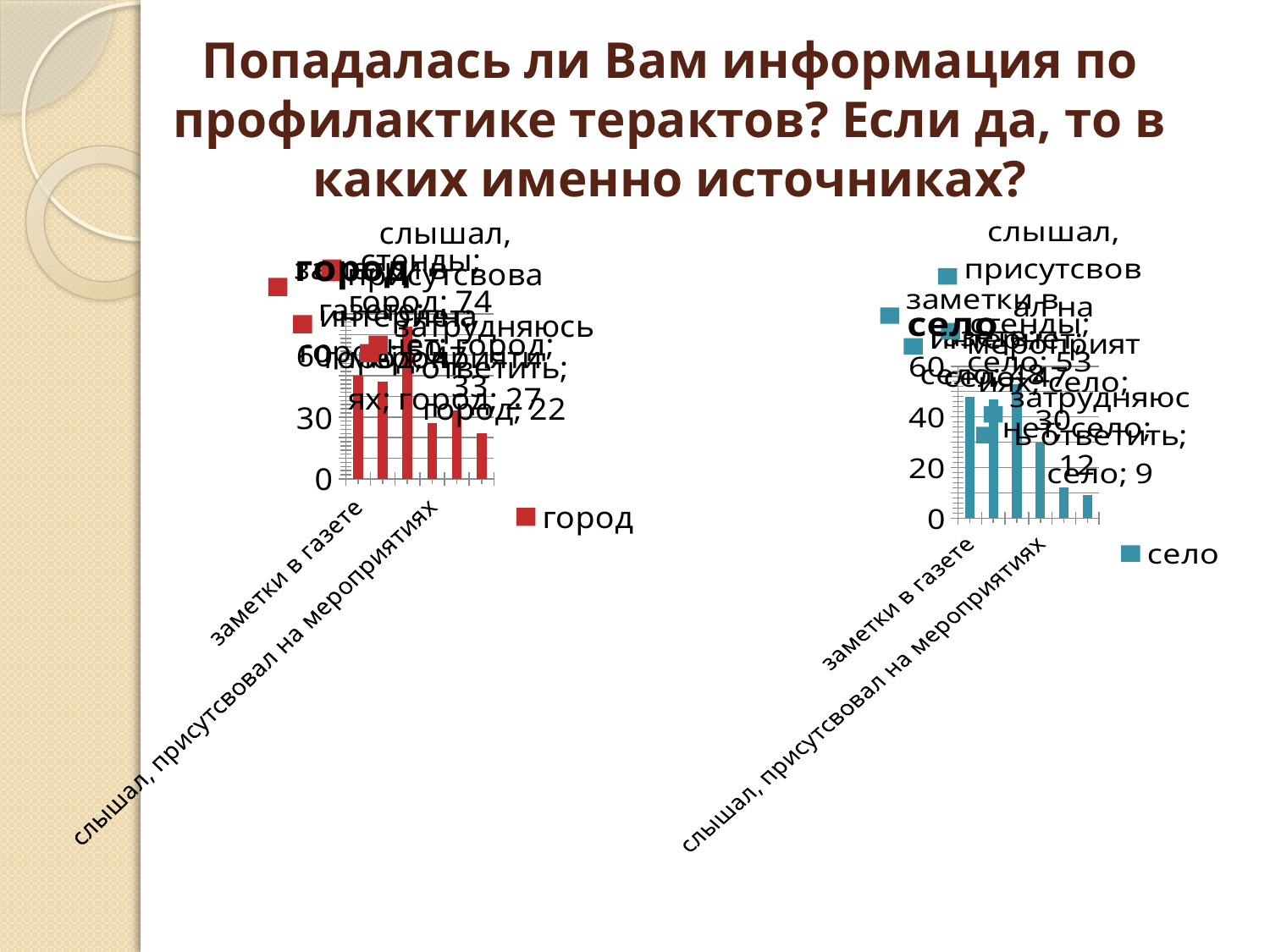
How many series does the legend of the left chart list? 1 In the right chart ("село"), which category has the highest bar? стенды What is the legend entry of the right chart? село What kind of chart is the right chart titled "село"? bar chart In the left chart ("город"), is the value for "заметки в газете" greater or less than 30? greater In the right chart ("село"), is the value for "слышал, присутсвовал на мероприятиях" greater or less than 40? less What kind of chart is the left chart titled "город"? bar chart How many bars are plotted in the left chart ("город")? 6 How many bars are plotted in the right chart ("село")? 6 In the right chart ("село"), which is larger: the value for "заметки в газете" or for "слышал, присутсвовал на мероприятиях"? заметки в газете In the left chart ("город"), which category has the highest bar? стенды In the right chart ("село"), is the value for "заметки в газете" greater or less than 40? greater